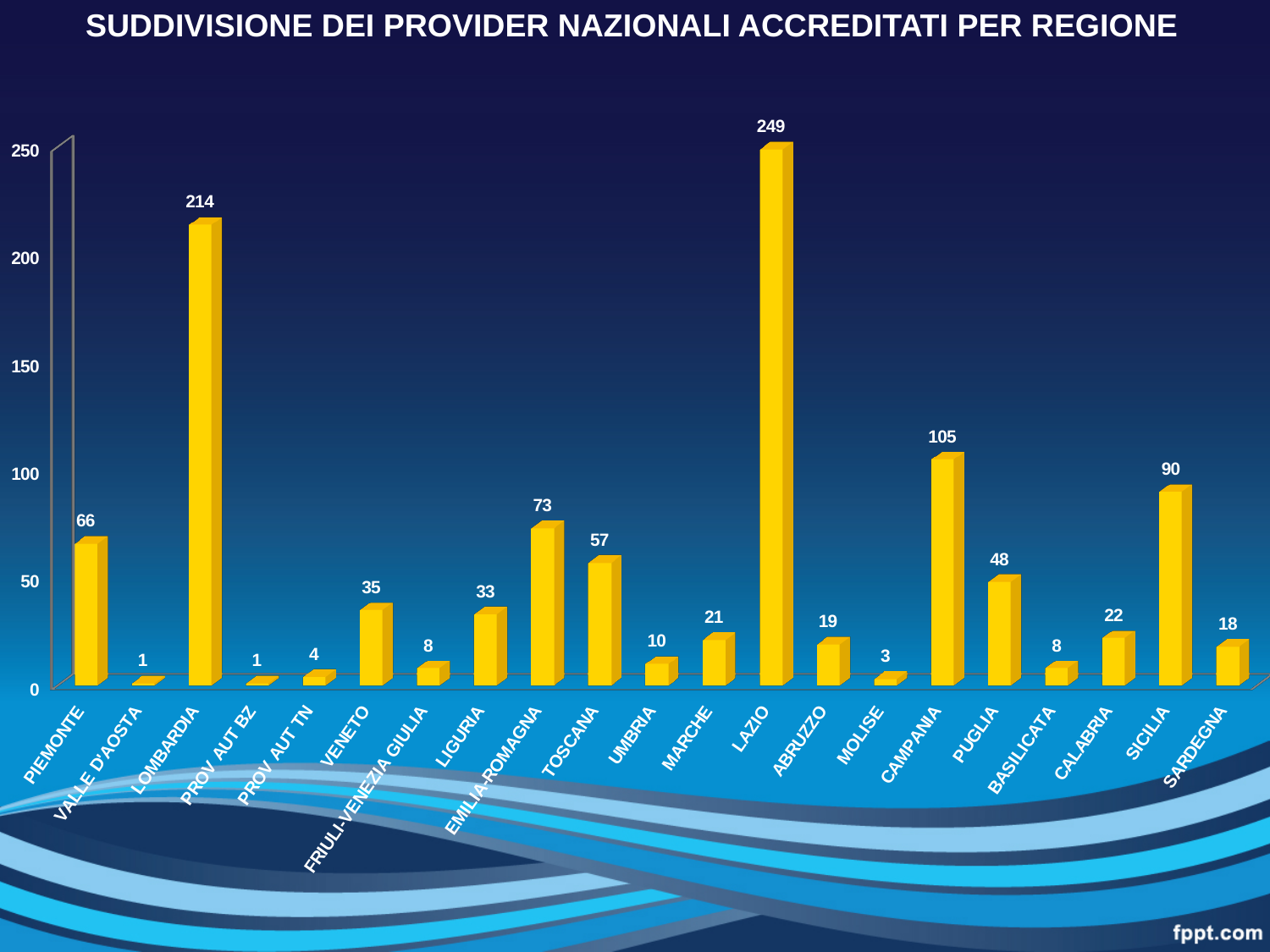
What is the value for CAMPANIA? 105 What is the title of the chart? SUDDIVISIONE DEI PROVIDER NAZIONALI ACCREDITATI PER REGIONE What is the value for EMILIA-ROMAGNA? 73 Which is larger, the value for SICILIA or the value for PUGLIA? SICILIA What is the difference between the values for LAZIO and LOMBARDIA? 35 What is the difference between the values for TOSCANA and VENETO? 22 How many regions are shown on the x axis? 21 What is the value for MOLISE? 3 Is the value for PIEMONTE greater or less than 50? greater What kind of chart is shown on the slide? bar chart What is the value for LOMBARDIA? 214 Which region has the highest value? LAZIO